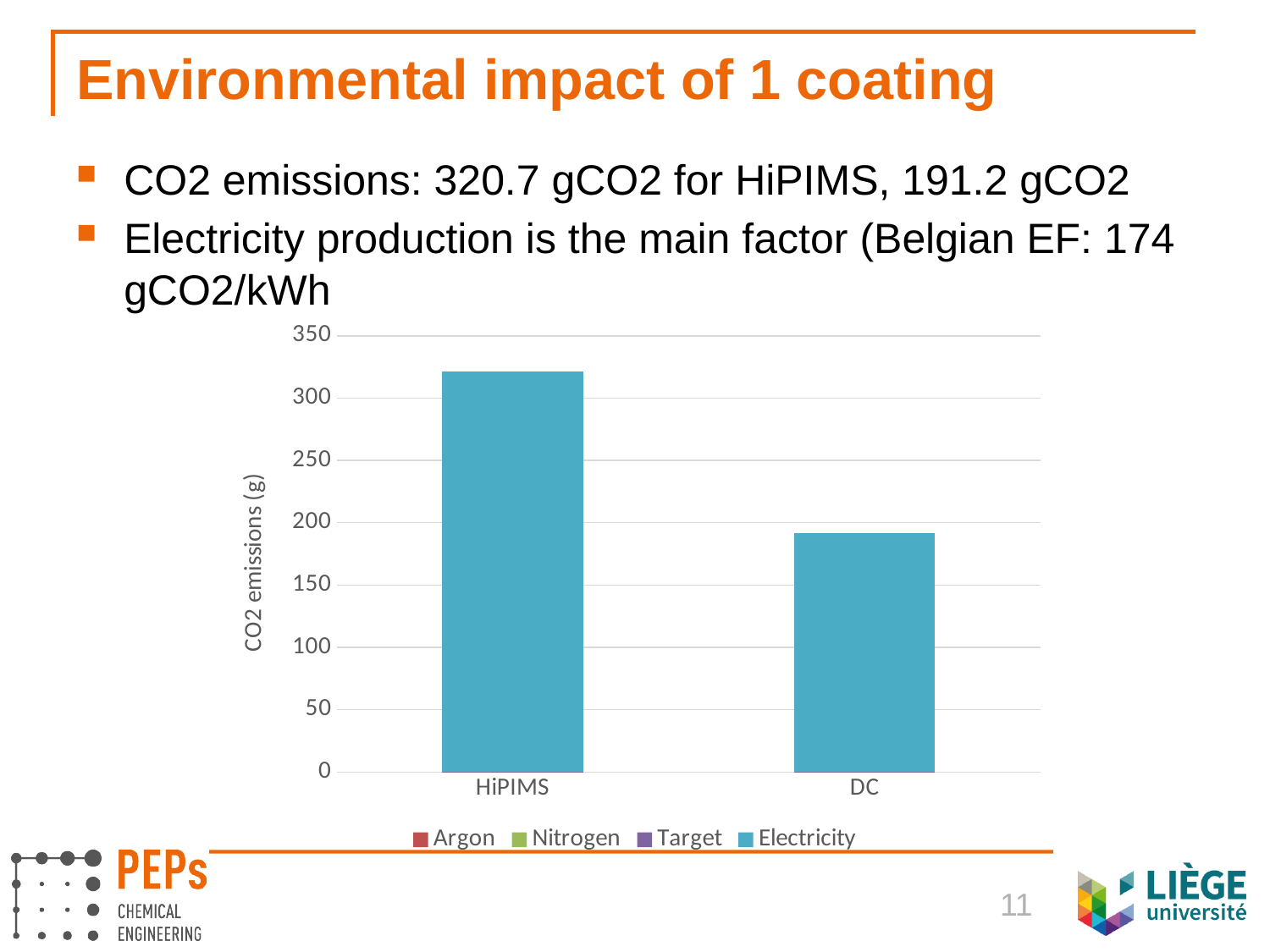
Is the value for DC greater or less than 150? greater How many series does the chart's legend list? 4 Is the value for HiPIMS greater or less than 350? less What is the title of the chart's vertical axis? CO2 emissions (g) Which category has the highest CO2 emissions in the chart? HiPIMS Is the value for HiPIMS greater or less than 300? greater Which category has the lowest CO2 emissions in the chart? DC How many categories are shown on the x axis of the chart? 2 Which bar is taller, HiPIMS or DC? HiPIMS What kind of chart is shown on the slide? bar chart Which series in the legend is shown in teal/blue? Electricity